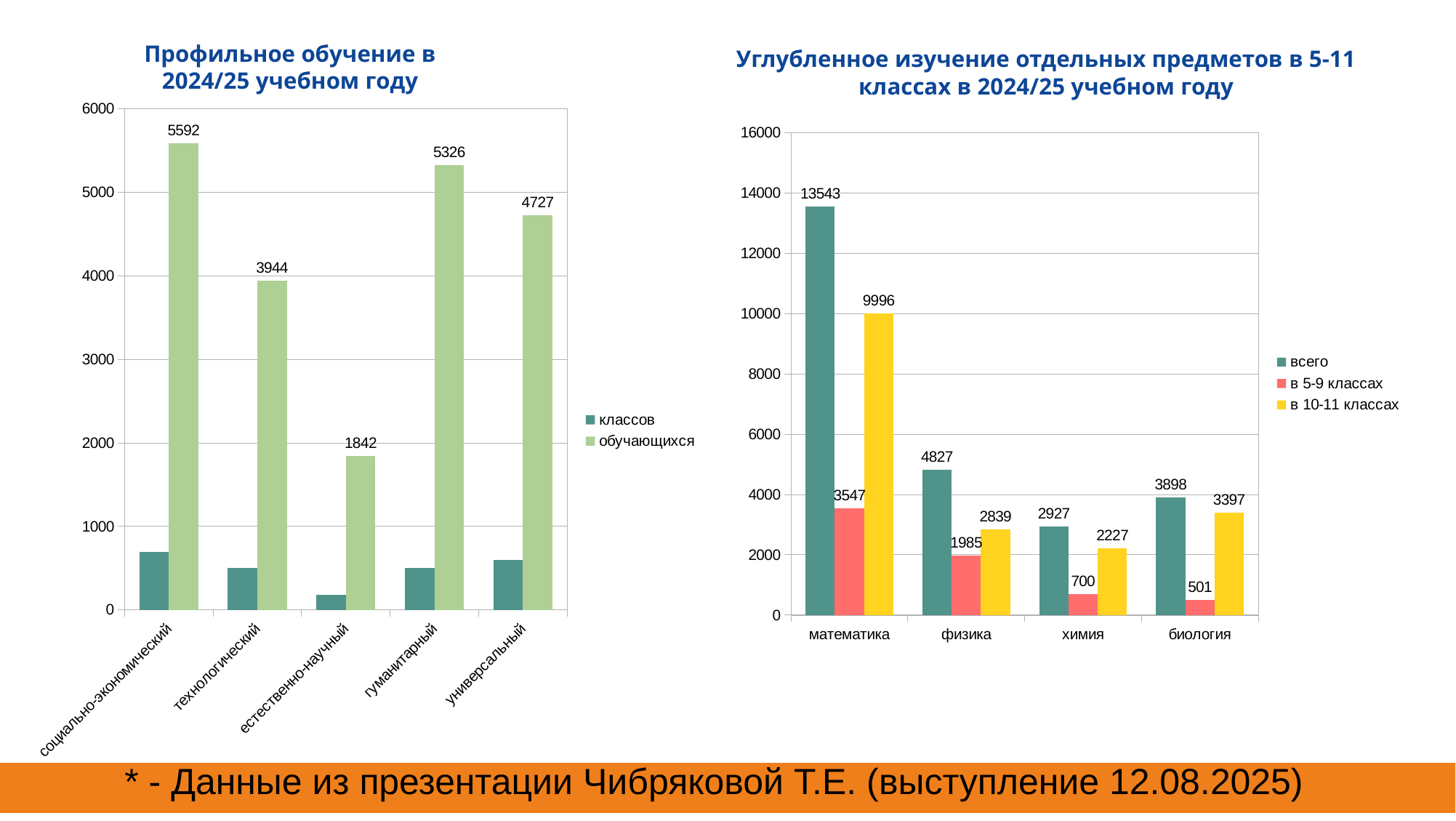
In the chart 'Углубленное изучение отдельных предметов в 5-11 классах в 2024/25 учебном году', how many series does the legend list? 3 In the chart 'Углубленное изучение отдельных предметов в 5-11 классах в 2024/25 учебном году', what is the difference between 'всего' for 'физика' and 'всего' for 'биология'? 929 In the chart 'Углубленное изучение отдельных предметов в 5-11 классах в 2024/25 учебном году', which subject has the highest value for 'всего'? математика In the chart 'Профильное обучение в 2024/25 учебном году', is the value of 'классов' for 'естественно-научный' greater or less than 1000? less In the chart 'Профильное обучение в 2024/25 учебном году', how many categories are shown on the x axis? 5 In the chart 'Углубленное изучение отдельных предметов в 5-11 классах в 2024/25 учебном году', which is larger: 'в 5-9 классах' for 'химия' or 'в 5-9 классах' for 'биология'? химия In the chart 'Профильное обучение в 2024/25 учебном году', which category has the lowest value for 'обучающихся'? естественно-научный What type of chart is the one on the right side of the slide? bar chart In the chart 'Профильное обучение в 2024/25 учебном году', what is the value of 'обучающихся' for 'социально-экономический'? 5592 In the chart 'Профильное обучение в 2024/25 учебном году', how many series does the legend list? 2 In the chart 'Профильное обучение в 2024/25 учебном году', what is the difference between 'обучающихся' for 'гуманитарный' and 'универсальный'? 599 In the chart 'Углубленное изучение отдельных предметов в 5-11 классах в 2024/25 учебном году', what is the value of 'в 10-11 классах' for 'математика'? 9996